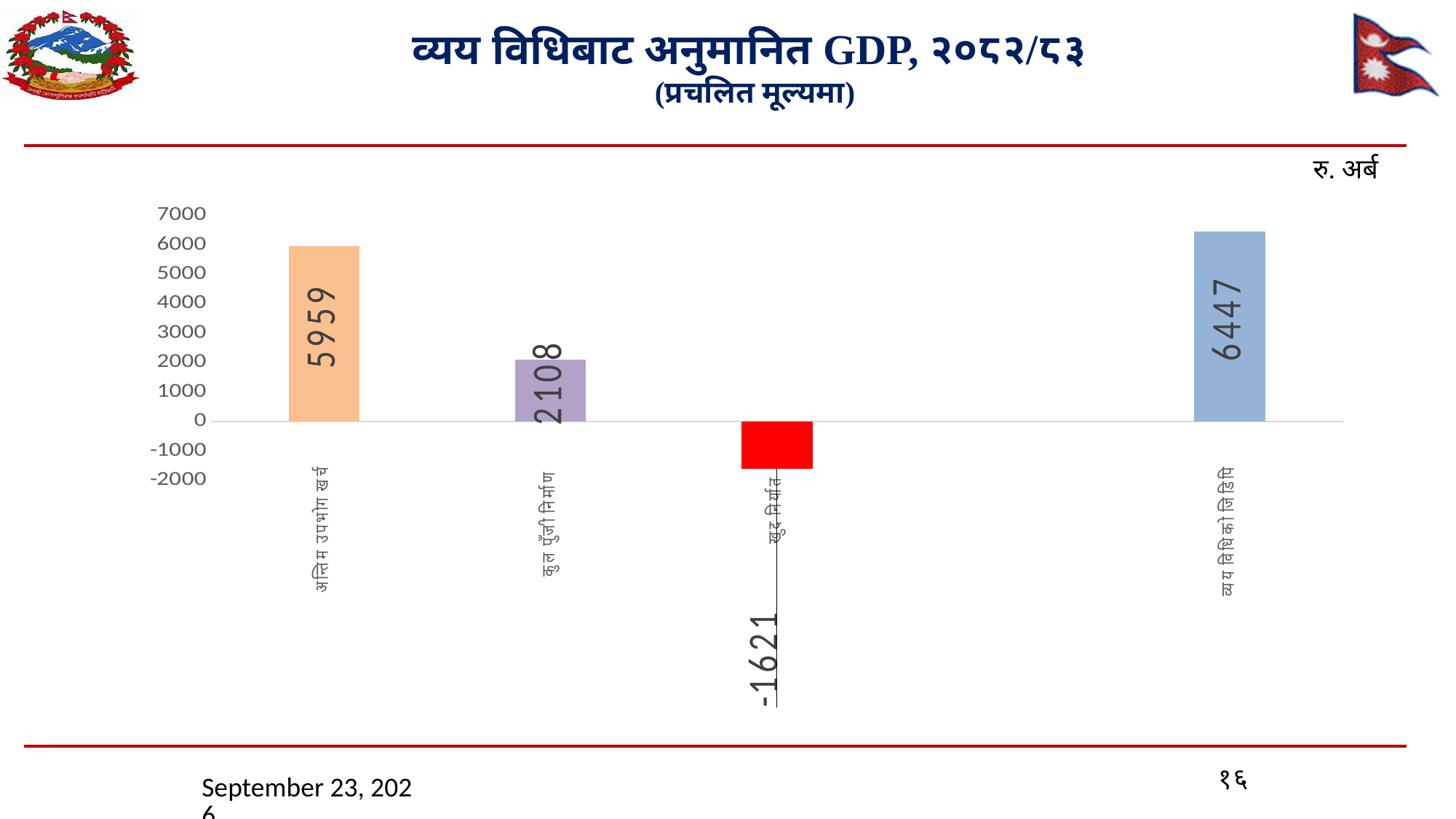
Which category has the lowest value? खुद निर्यात What kind of chart is shown on the slide? bar chart What is the value for खुद निर्यात? -1621 What is the value for व्यय विधिको जिडिपि? 6447 Which is larger, अन्तिम उपभोग खर्च or कुल पुँजी निर्माण? अन्तिम उपभोग खर्च What is the value for कुल पुँजी निर्माण? 2108 How many categories are shown in the chart? 4 Which category has the highest value? व्यय विधिको जिडिपि What is the value for अन्तिम उपभोग खर्च? 5959 What unit is indicated for the chart values? रु. अर्ब What is the difference between अन्तिम उपभोग खर्च and कुल पुँजी निर्माण? 3851 What is the difference between व्यय विधिको जिडिपि and अन्तिम उपभोग खर्च? 488